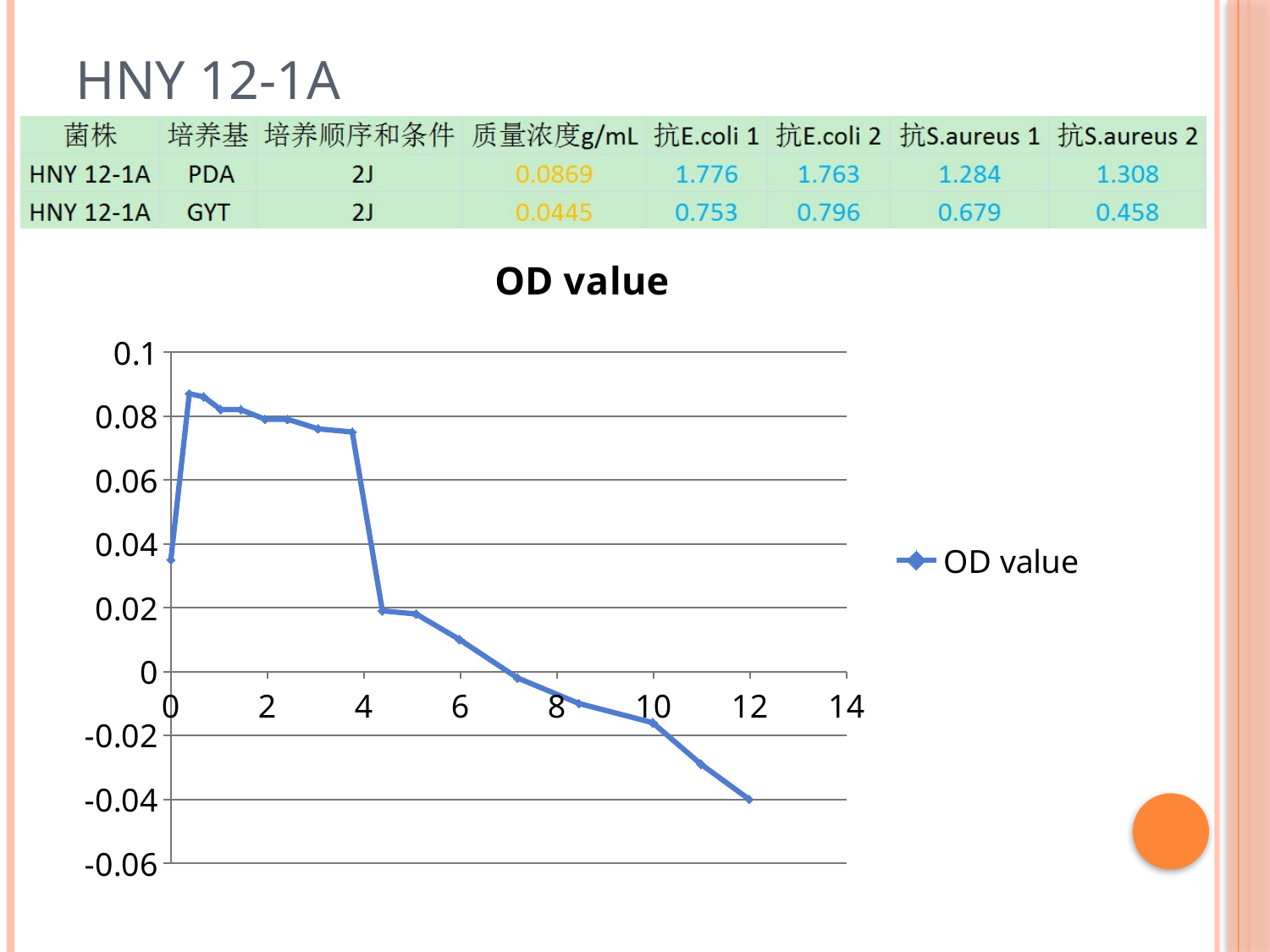
Is the OD value at x = 0 greater or less than 0.02? greater Is the OD value at x = 6 greater or less than 0? greater Is the OD value at x = 12 greater or less than -0.02? less What is the title of the chart? OD value Overall, do the OD values rise or fall as the x axis increases from 4 to 12? fall What kind of chart is shown on the slide? line chart What is the name of the series shown in the chart legend? OD value Is the OD value at x = 12 larger or smaller than the OD value at x = 0? smaller How many series does the chart legend list? 1